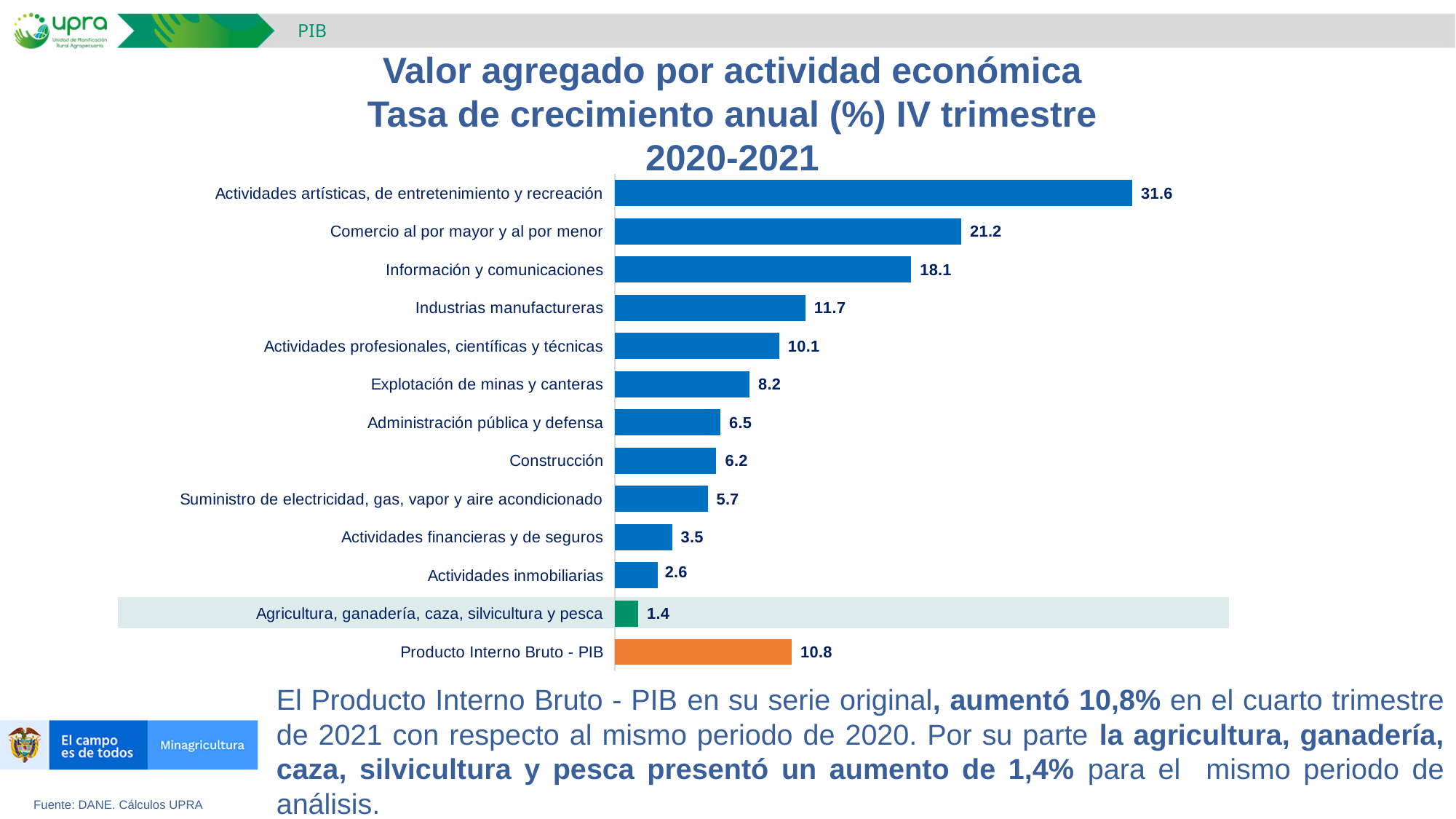
Which category has the lowest value? Agricultura, ganadería, caza, silvicultura y pesca What is the value for Industrias manufactureras? 11.7 What is the value for Actividades artísticas, de entretenimiento y recreación? 31.6 What is the difference between the values for Comercio al por mayor y al por menor and Información y comunicaciones? 3.1 Which is larger, the value for Construcción or the value for Administración pública y defensa? Administración pública y defensa What is the value for Agricultura, ganadería, caza, silvicultura y pesca? 1.4 What kind of chart is shown on the slide? Bar chart What is the value for Producto Interno Bruto - PIB? 10.8 How many categories (bars) are shown in the chart? 13 What colour is the bar for Producto Interno Bruto - PIB? Orange Which category has the highest value? Actividades artísticas, de entretenimiento y recreación What is the difference between the value for Producto Interno Bruto - PIB and the value for Agricultura, ganadería, caza, silvicultura y pesca? 9.4